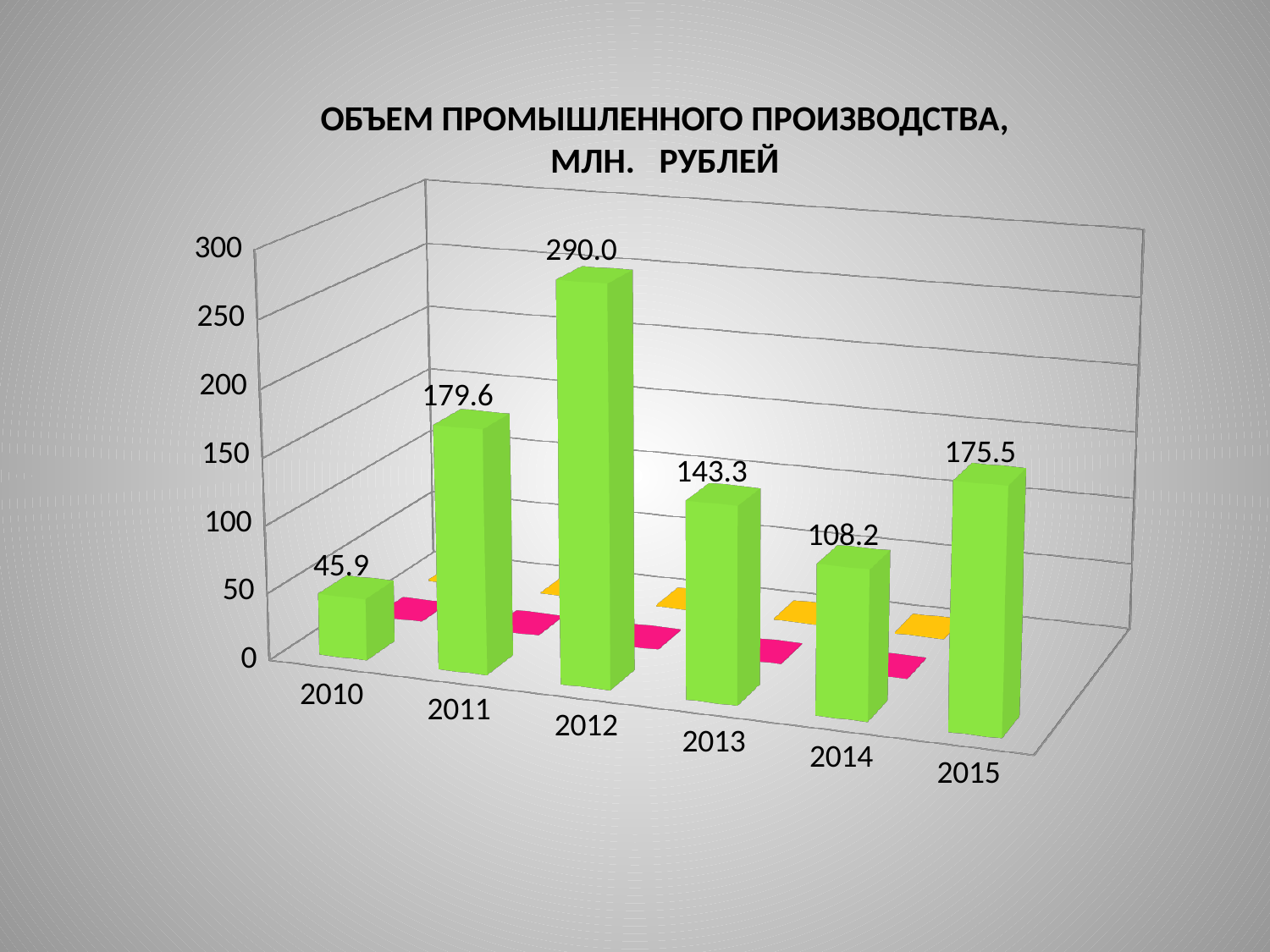
Do the values rise or fall from 2010 to 2012? rise What is the value for 2014? 108.2 How many years are shown on the x axis? 6 What kind of chart is shown on the slide? bar chart What is the value for 2012? 290.0 What is the difference between the values for 2012 and 2011? 110.4 What is the value for 2010? 45.9 What is the difference between the values for 2015 and 2014? 67.3 Which is larger, the value for 2011 or the value for 2015? 2011 What is the value for 2015? 175.5 Which year has the lowest value? 2010 Which year has the highest value? 2012